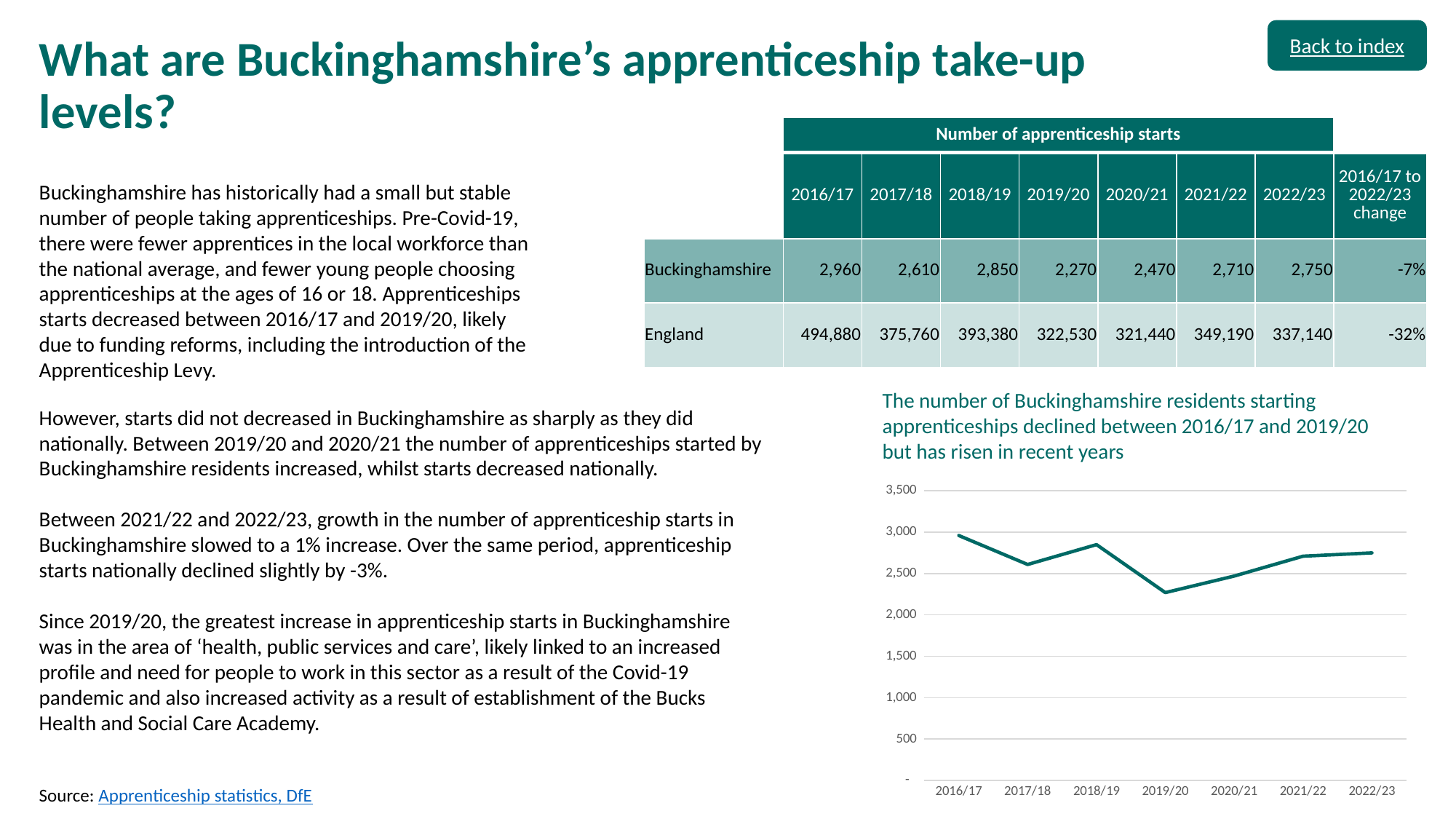
What is the highest value shown on the y axis of the line chart? 3,500 According to the table, what is the difference between Buckinghamshire's apprenticeship starts in 2016/17 and 2022/23? 210 What kind of chart is shown on the slide? line chart In the line chart, is the value for 2022/23 greater or less than 3,000? less In the line chart, is the value for 2018/19 larger or smaller than the value for 2017/18? larger Which year has the highest value in the line chart? 2016/17 Which year has the lowest value in the line chart? 2019/20 Does the line chart rise or fall between 2019/20 and 2022/23? rise In the line chart, is the value for 2019/20 greater or less than 2,500? less In the line chart, is the value for 2016/17 greater or less than 2,500? greater According to the table, how many apprenticeship starts did Buckinghamshire have in 2019/20, the lowest point on the line chart? 2,270 How many years are plotted along the x axis of the line chart? 7